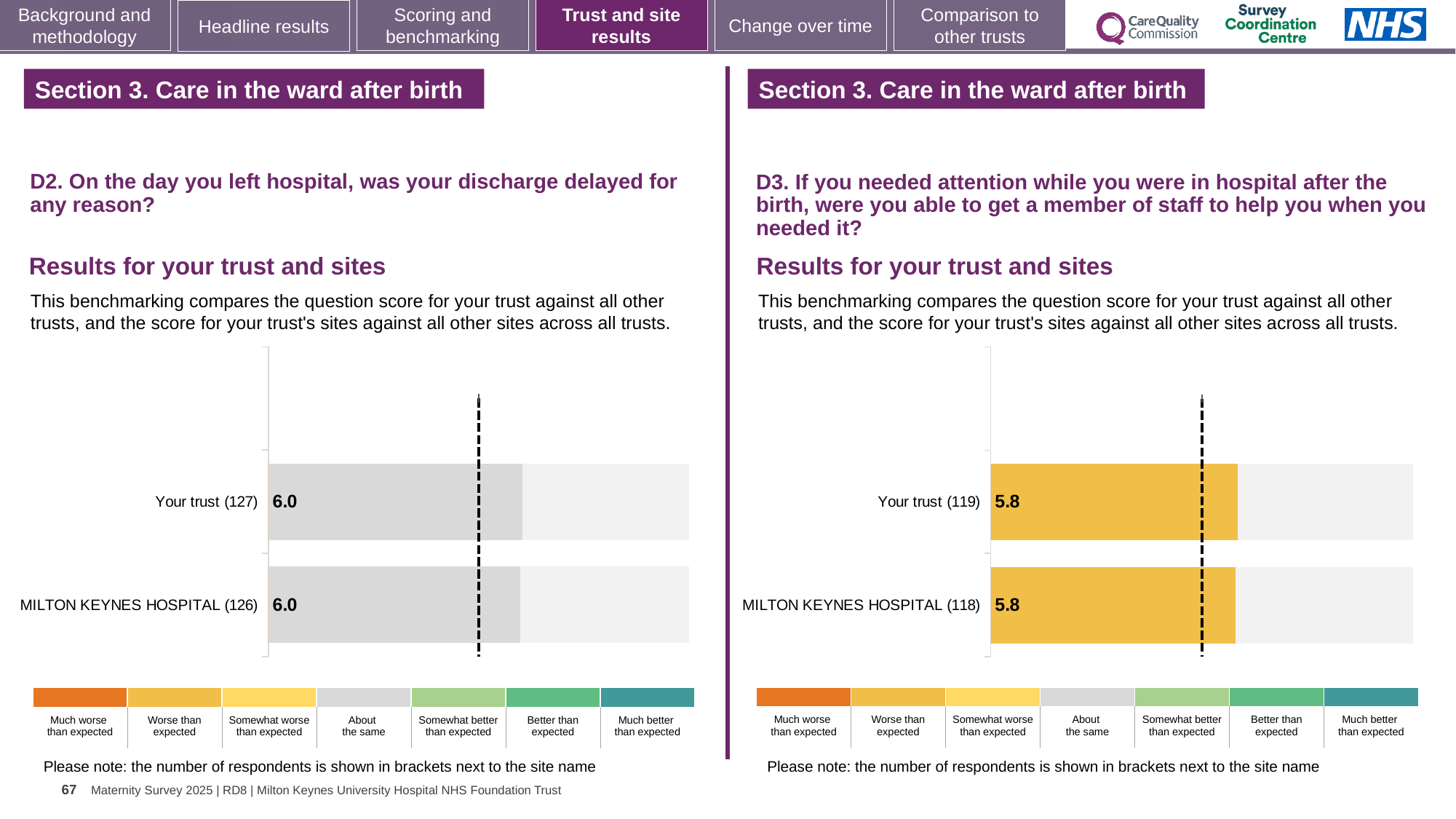
What kind of chart is used in the D2 chart (left)? Bar chart In the D2 chart (left), which benchmark category does the colour of the bars correspond to according to the legend? About the same In the D3 chart (right), which benchmark category does the colour of the bars correspond to according to the legend? Worse than expected In the D3 chart (right), what is the score for Your trust? 5.8 In the D2 chart (left), what is the score for MILTON KEYNES HOSPITAL? 6.0 In the D2 chart (left), what is the difference between the score for Your trust and the score for MILTON KEYNES HOSPITAL? 0.0 In the D3 chart (right), what is the difference between the score for Your trust and the score for MILTON KEYNES HOSPITAL? 0.0 In the D2 chart (left), what is the score for Your trust? 6.0 How many bars are plotted in the D3 chart (right)? 2 In the D3 chart (right), what is the score for MILTON KEYNES HOSPITAL? 5.8 How many bars are plotted in the D2 chart (left)? 2 How many respondents are shown in brackets for Your trust in the D3 chart (right)? 119